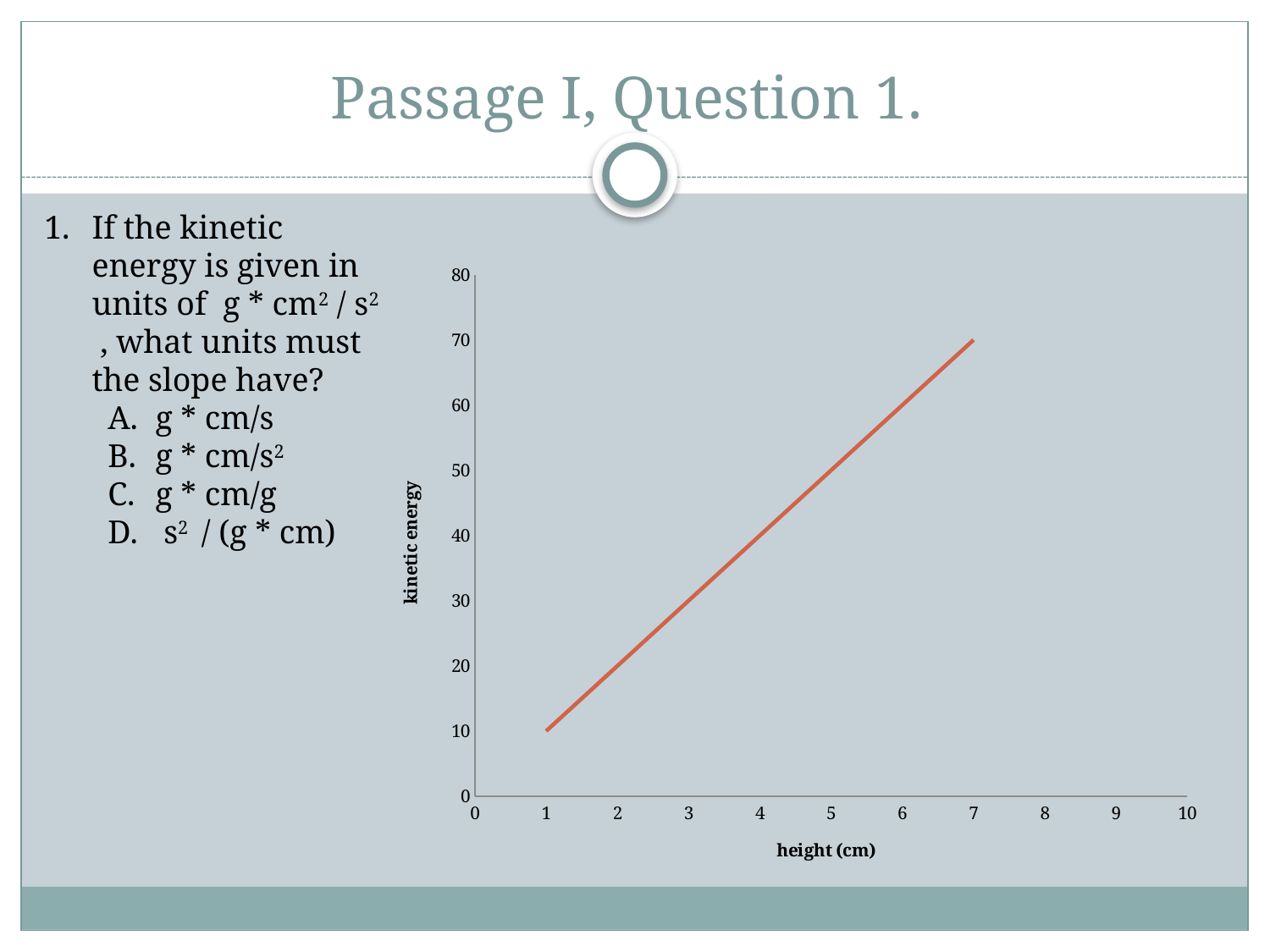
What is the highest value shown on the y axis? 80 At which height shown on the line is the kinetic energy highest, 1 cm or 7 cm? 7 cm Is the kinetic energy at a height of 6 cm greater or less than 50? greater Is the kinetic energy at a height of 4 cm greater or less than 30? greater What is the kinetic energy at a height of 7 cm? 70 Is the kinetic energy at a height of 2 cm greater or less than 30? less What is the difference in kinetic energy between a height of 7 cm and a height of 1 cm? 60 What is the label on the y axis of the chart? kinetic energy Does kinetic energy rise or fall as height increases along the x axis? rise What is the label on the x axis of the chart? height (cm) What is the kinetic energy at a height of 1 cm? 10 What kind of chart is shown on the slide? line chart